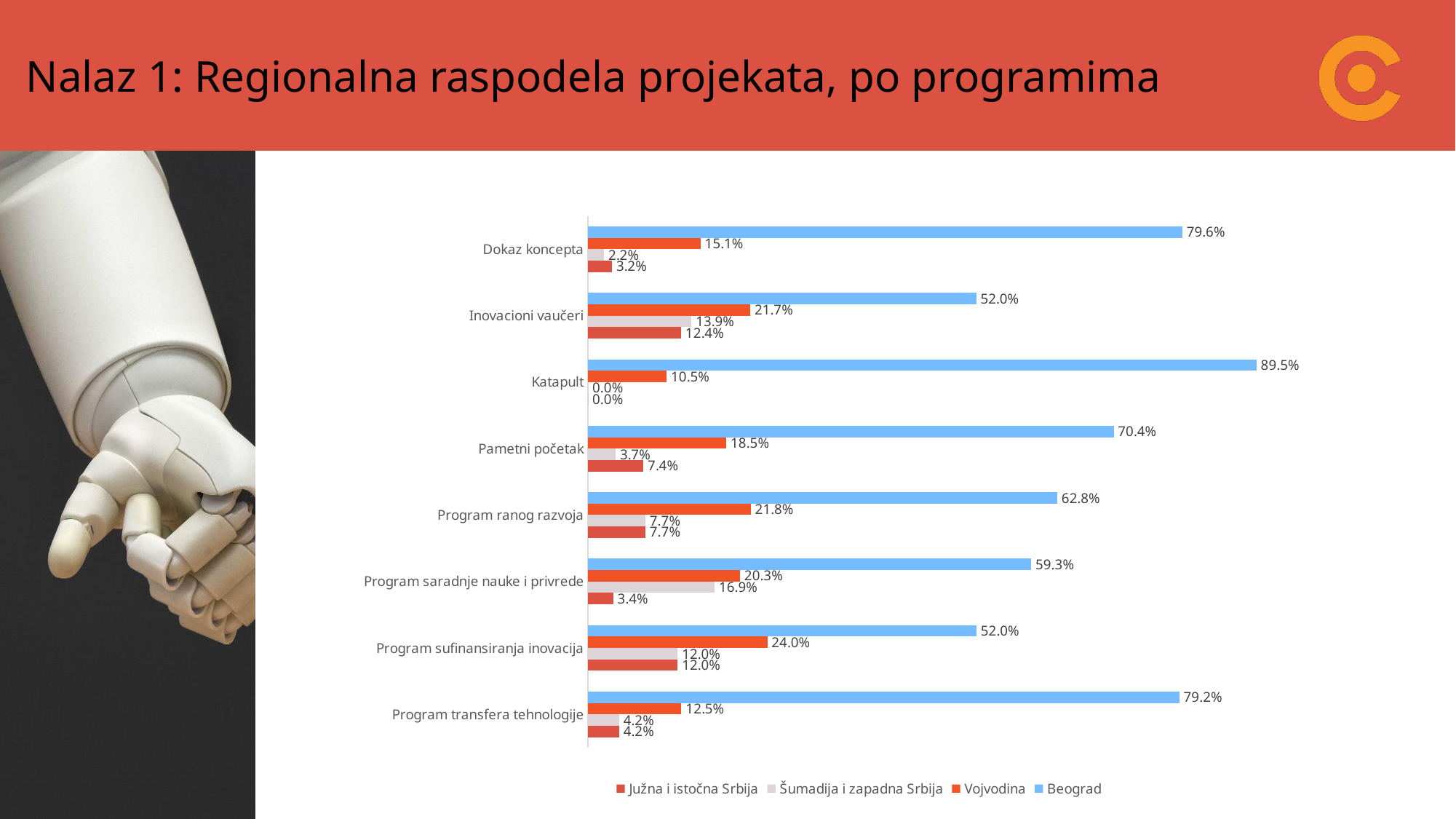
What is the value for Beograd in the Katapult program? 89.5% Which program has the lowest value for Vojvodina? Katapult What is the value for Južna i istočna Srbija in the Dokaz koncepta category? 3.2% Which series is shown in blue in the legend? Beograd What is the difference between the Beograd values for Dokaz koncepta and Inovacioni vaučeri? 27.6% Which is larger: the Vojvodina value for Pametni početak or for Program ranog razvoja? Program ranog razvoja What kind of chart is shown on the slide? Bar chart What is the value for Vojvodina in the Program sufinansiranja inovacija category? 24.0% How many programs (categories) are shown on the chart? 8 How many series does the legend list? 4 What is the value for Šumadija i zapadna Srbija in the Program saradnje nauke i privrede category? 16.9% Which program has the highest value for Beograd? Katapult